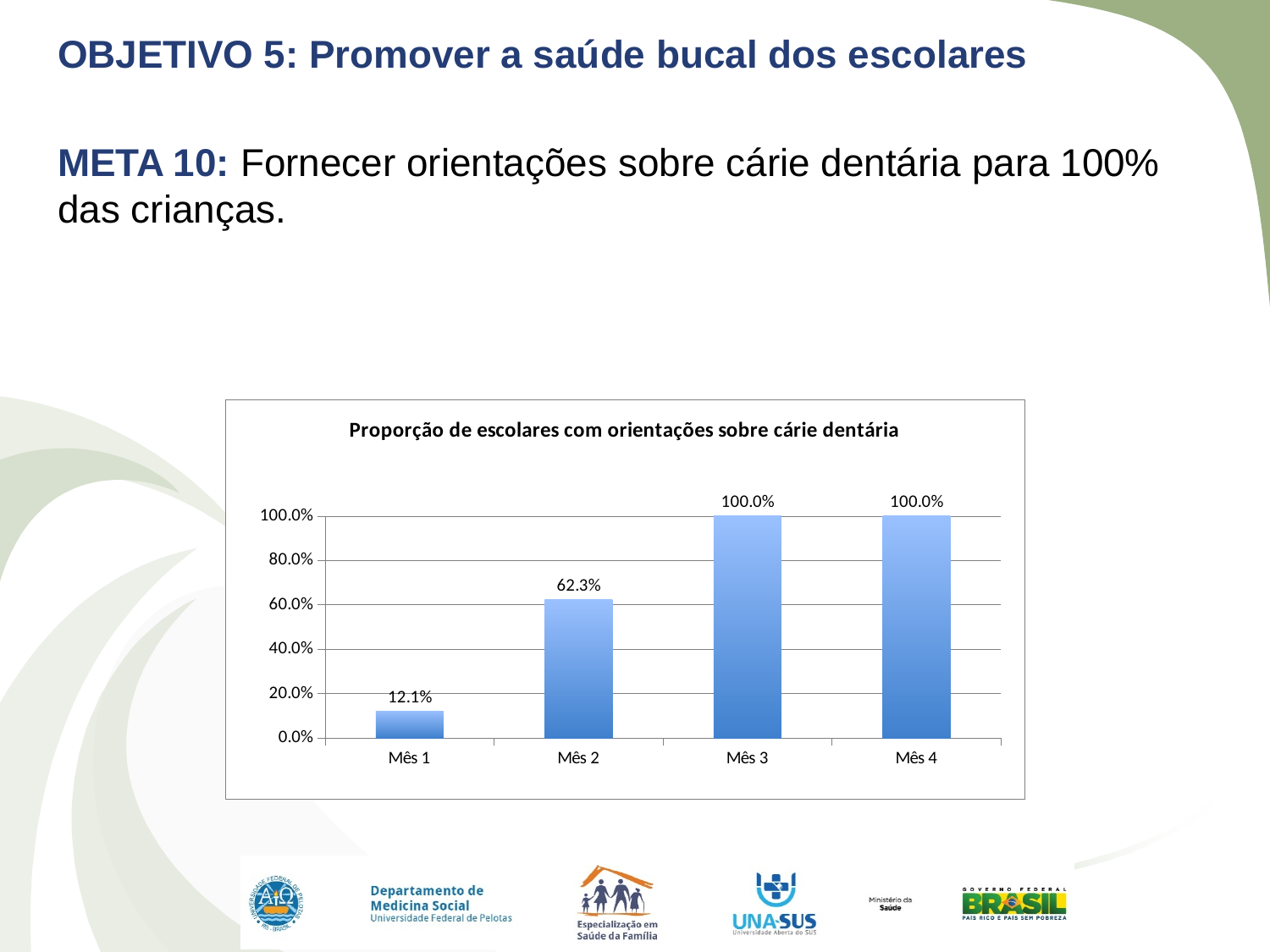
What is the title of the chart? Proporção de escolares com orientações sobre cárie dentária Which month has the lowest value? Mês 1 What is the difference between the values for Mês 2 and Mês 1? 50.2% What is the value for Mês 2? 62.3% What is the difference between the values for Mês 3 and Mês 2? 37.7% What kind of chart is shown? bar chart Which is larger, the value for Mês 2 or the value for Mês 1? Mês 2 What is the value for Mês 3? 100.0% Do the values rise or fall from Mês 1 to Mês 3? rise How many months are shown on the x axis? 4 Is the value for Mês 2 greater or less than 40.0%? greater What is the value for Mês 1? 12.1%